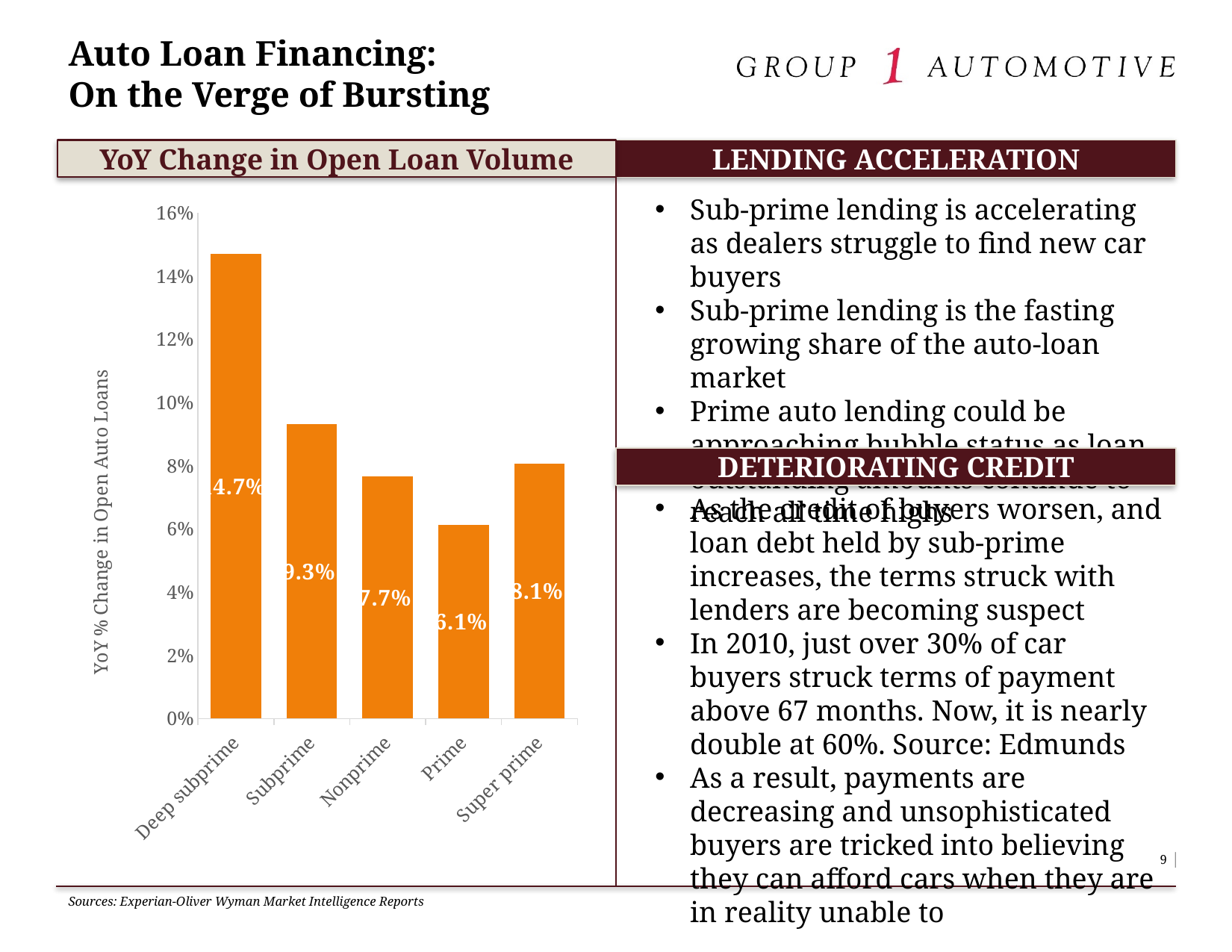
What is the YoY change in open loan volume for Subprime? 9.3% What is the difference between the Subprime and Prime values? 3.2% What is the YoY change in open loan volume for Nonprime? 7.7% Which is larger, the value for Super prime or the value for Nonprime? Super prime What is the label of the chart's vertical axis? YoY % Change in Open Auto Loans Which category has the lowest YoY change in open loan volume? Prime How many categories are shown on the x axis of the chart? 5 Which category has the highest YoY change in open loan volume? Deep subprime What is the YoY change in open loan volume for Prime? 6.1% What is the YoY change in open loan volume for Super prime? 8.1% Is the value for Deep subprime greater or less than 14%? greater What kind of chart is shown under "YoY Change in Open Loan Volume"? Bar chart